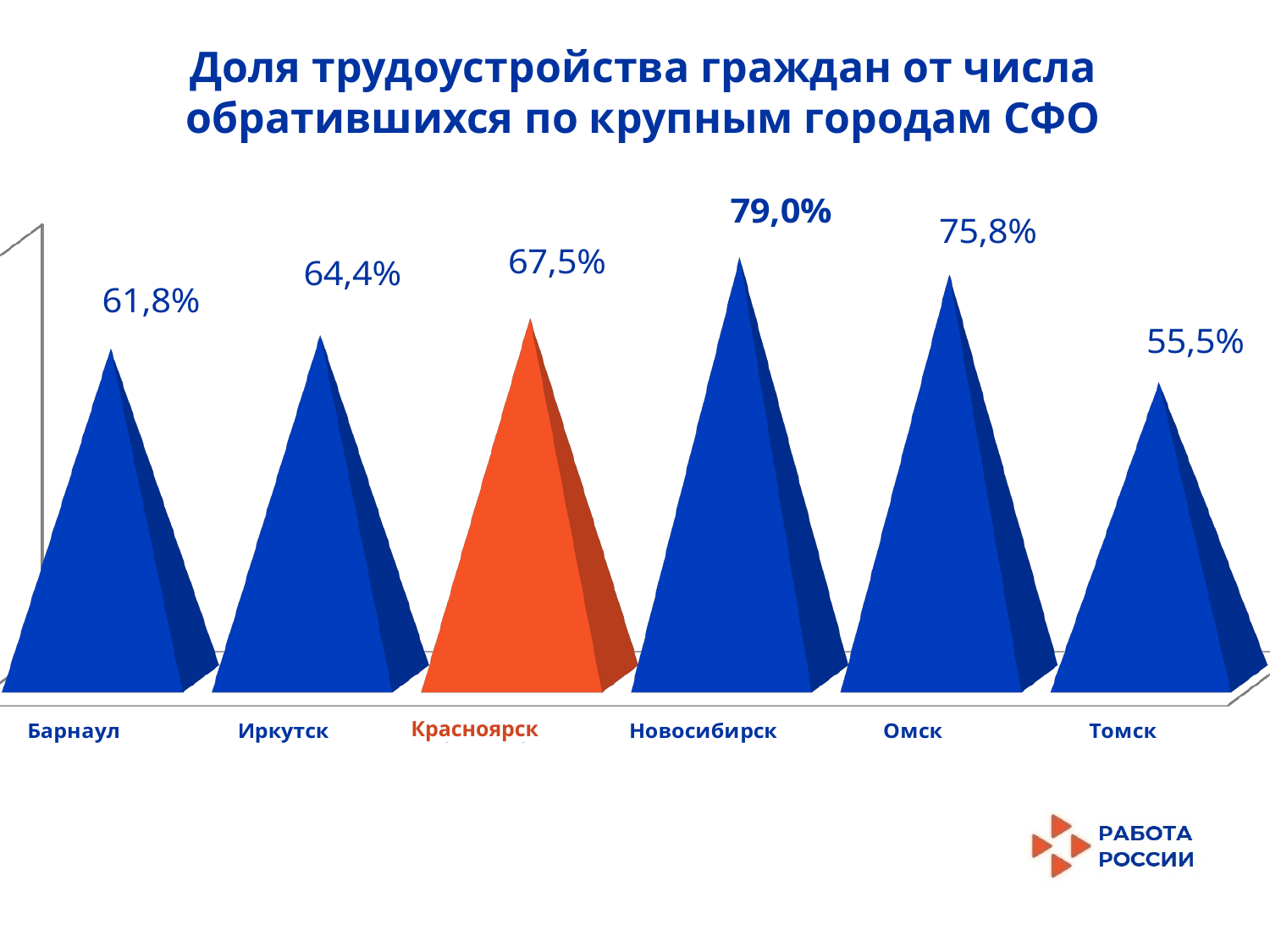
Which is larger, the value for Иркутск or the value for Омск? Омск What is the value for Новосибирск? 79,0% What is the difference between the values for Новосибирск and Омск? 3,2% What is the difference between the values for Красноярск and Барнаул? 5,7% What is the value for Красноярск? 67,5% Which city has the lowest value? Томск What is the value for Томск? 55,5% Which city's bar is shown in orange instead of blue? Красноярск What kind of chart is this? Bar chart What is the value for Барнаул? 61,8% How many cities are shown on the chart? 6 Which city has the highest value? Новосибирск